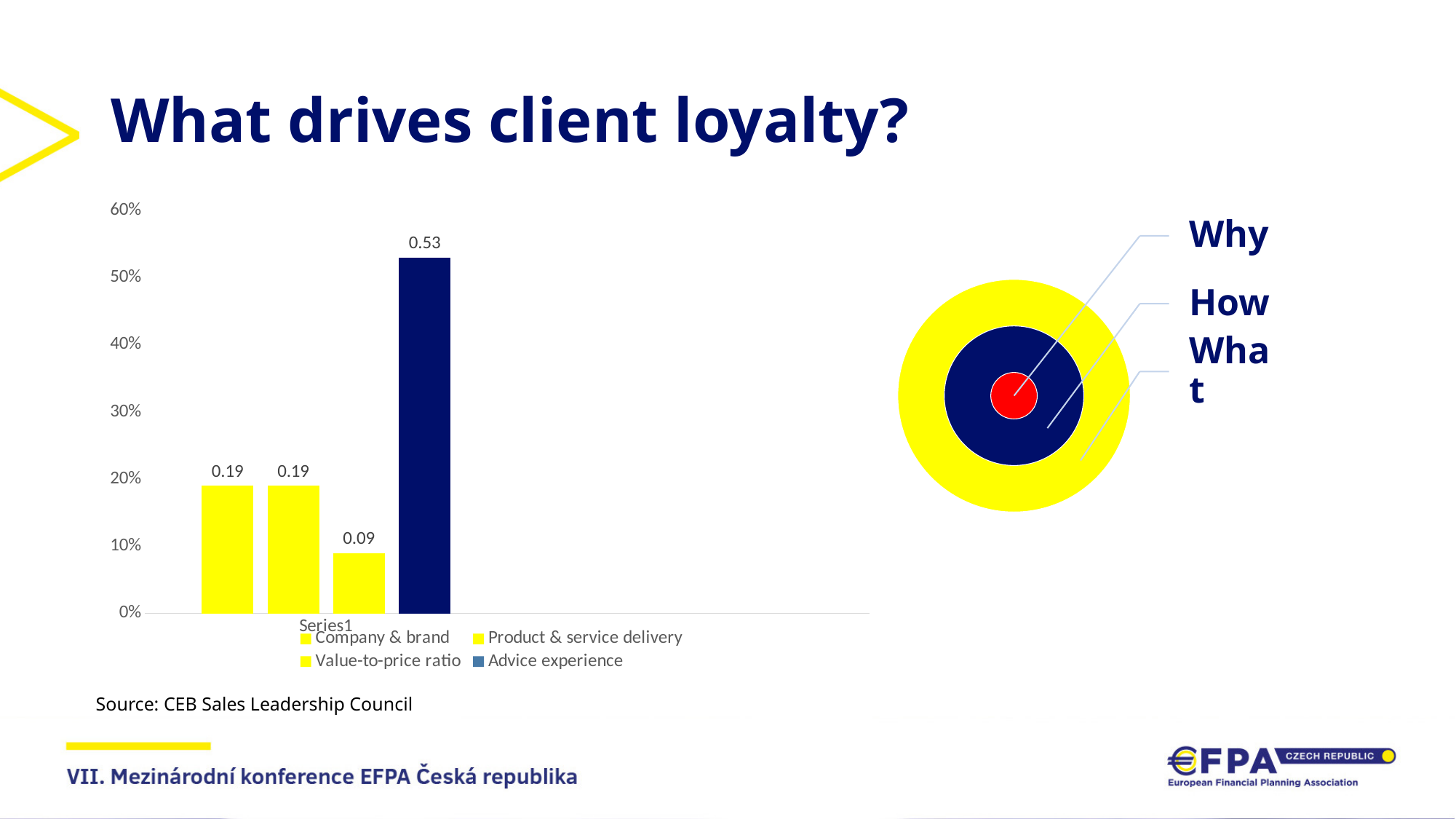
Which series has the highest value? Advice experience What is the value shown for Company & brand? 0.19 Which series has the lowest value? Value-to-price ratio Which is larger, the value for Advice experience or the value for Product & service delivery? Advice experience What is the difference between the values for Advice experience and Value-to-price ratio? 0.44 What is the value shown for Advice experience? 0.53 Is the bar for Advice experience greater or less than 50%? greater What kind of chart is shown on the slide? bar chart What source is cited below the chart? CEB Sales Leadership Council How many bars are plotted in the chart? 4 How many series does the legend list? 4 What is the value shown for Value-to-price ratio? 0.09